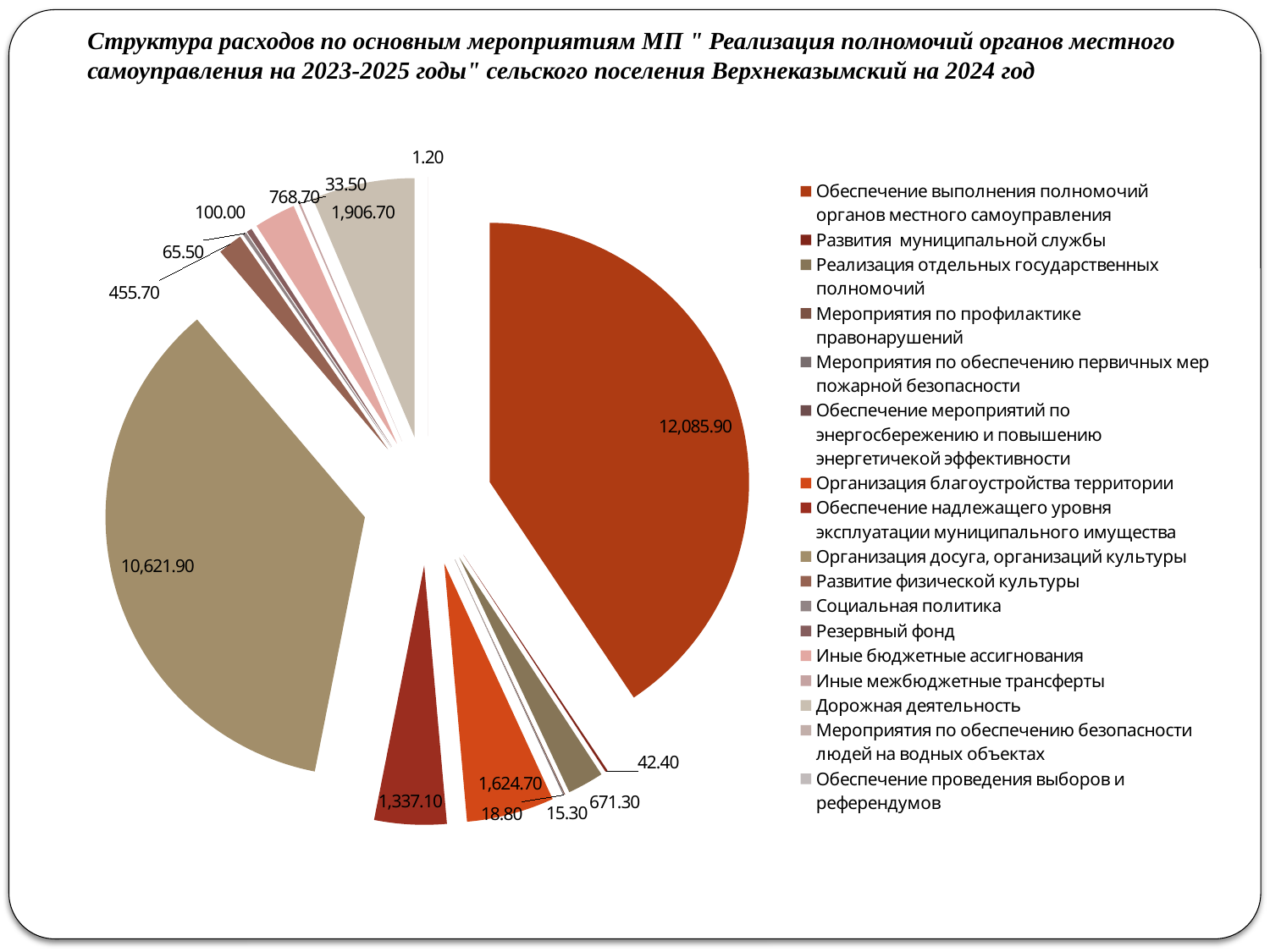
What is the difference between the two largest slices, 12,085.90 and 10,621.90? 1,464.00 What is the value for 'Дорожная деятельность'? 1,906.70 What is the value for 'Обеспечение надлежащего уровня эксплуатации муниципального имущества'? 1,337.10 What is the value of the largest slice in the pie chart? 12,085.90 What is the smallest data label shown on the pie chart? 1.20 What is the value for 'Иные бюджетные ассигнования'? 768.70 Which category has the largest slice in the pie chart? Обеспечение выполнения полномочий органов местного самоуправления Which is larger: the slice for 'Организация благоустройства территории' or the slice for 'Обеспечение надлежащего уровня эксплуатации муниципального имущества'? Организация благоустройства территории What is the value for 'Организация благоустройства территории'? 1,624.70 What kind of chart is shown on the slide? Pie chart How many categories are listed in the legend of the pie chart? 17 What is the value for 'Организация досуга, организаций культуры'? 10,621.90